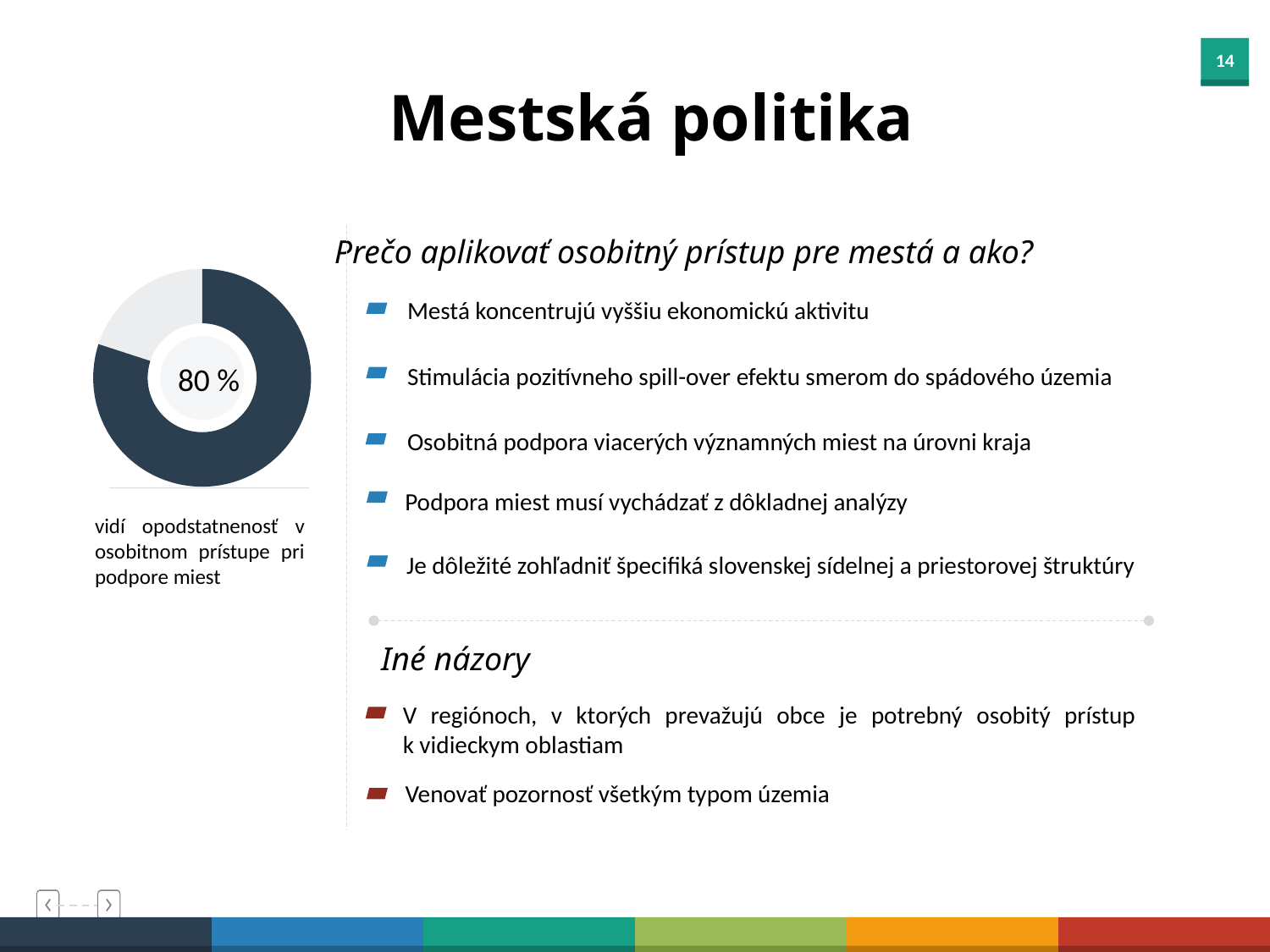
What percentage value is printed in the centre of the donut chart? 80 % According to the caption under the donut chart, what does the 80 % refer to? vidí opodstatnenosť v osobitnom prístupe pri podpore miest What colour is the slice representing 80 % in the donut chart? Dark blue What share of the donut chart does the light grey slice represent, given the dark slice is 80 %? 20 % Which slice of the donut chart is larger, the dark blue one or the light grey one? The dark blue one Is the share shown in the donut chart greater or less than half of the whole? greater How many slices does the donut chart have? 2 What kind of chart is shown on the left of the slide? Donut (pie) chart